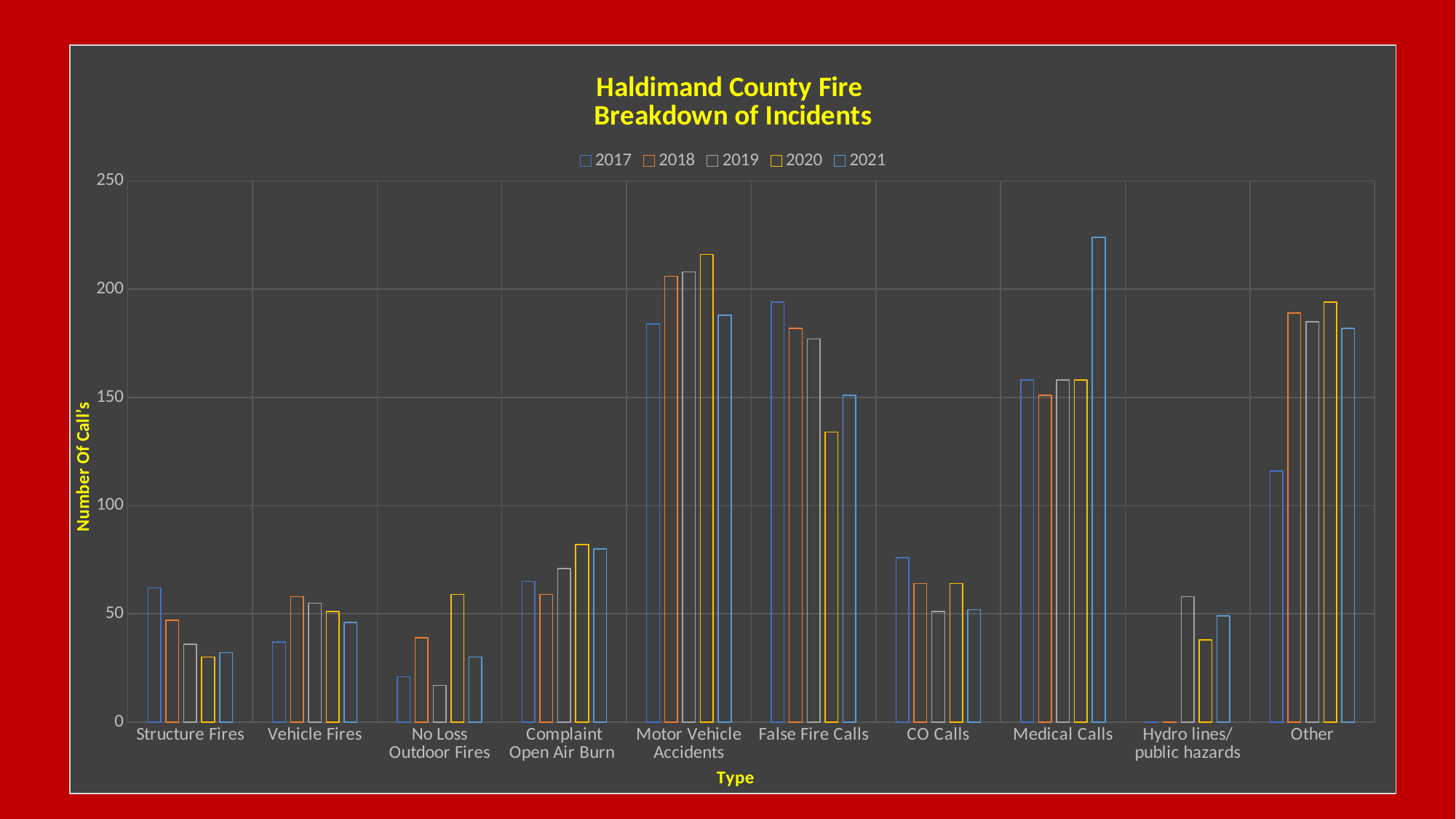
How many incident types (categories) are shown on the x axis? 10 For Structure Fires, do the values rise or fall from 2017 to 2020? fall Which incident type has the lowest 2017 value? Hydro lines/ public hazards What kind of chart is shown on the slide? Bar chart How many series does the legend list? 5 What is the title of the chart? Haldimand County Fire Breakdown of Incidents Is the 2020 value for Motor Vehicle Accidents greater or less than 200? greater Which is larger: the 2021 value for Medical Calls or the 2020 value for Motor Vehicle Accidents? 2021 value for Medical Calls Is the 2017 value for Other greater or less than 100? greater Which incident type has the tallest bar in the chart? Medical Calls For Structure Fires, which is larger: the 2017 value or the 2021 value? 2017 Is the 2020 value for False Fire Calls greater or less than 150? less